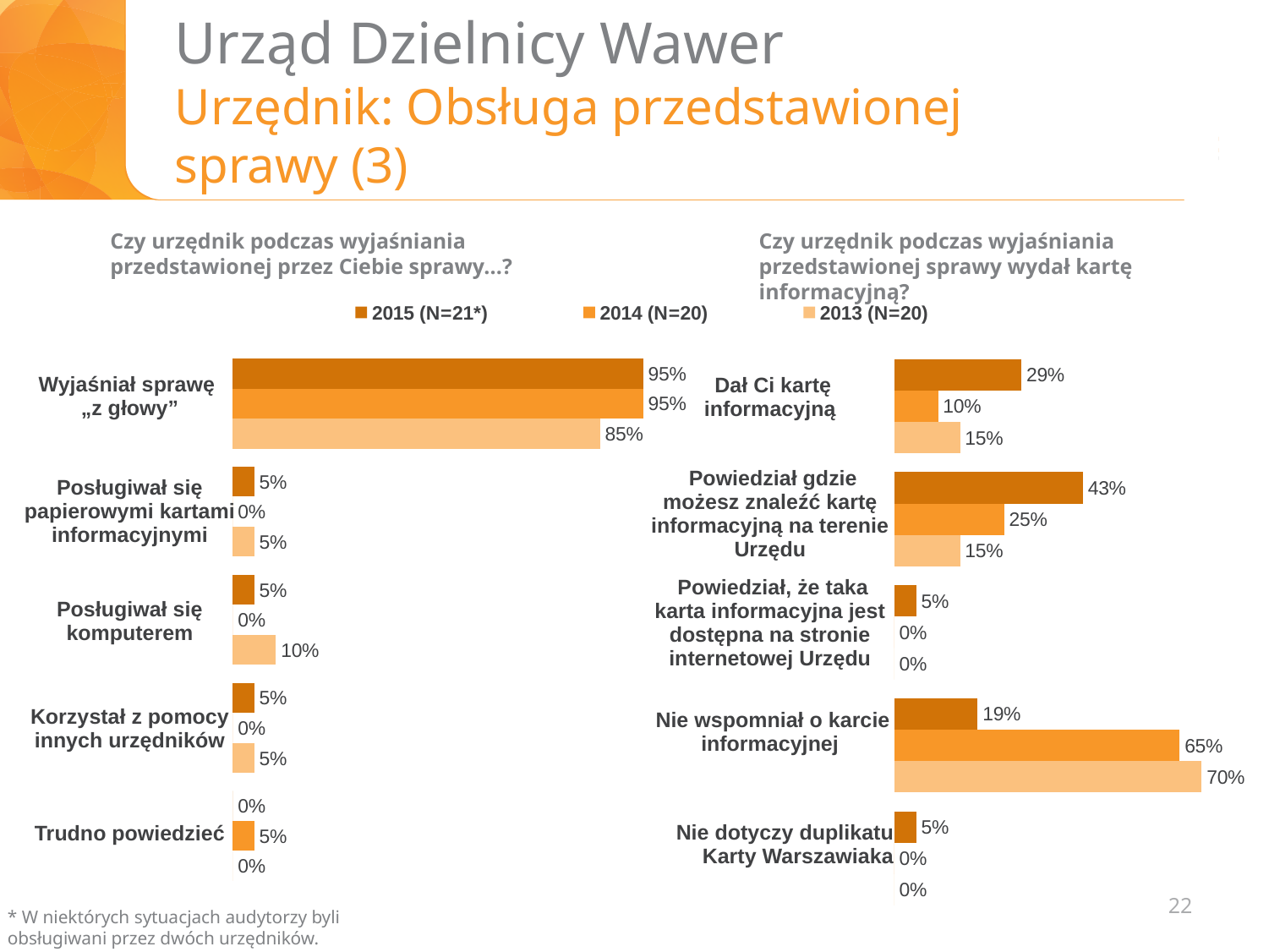
In the right chart, what is the 2014 (N=20) value for "Nie wspomniał o karcie informacyjnej"? 65% In the left chart, what is the 2013 (N=20) value for "Posługiwał się komputerem"? 10% What kind of chart is the right chart? Bar chart In the left chart, what is the 2014 (N=20) value for "Trudno powiedzieć"? 5% In the right chart, which category has the highest 2013 (N=20) value? Nie wspomniał o karcie informacyjnej How many categories does the left chart show? 5 In the left chart ("Czy urzędnik podczas wyjaśniania przedstawionej przez Ciebie sprawy...?"), what is the 2013 (N=20) value for "Wyjaśniał sprawę „z głowy”"? 85% How many series does the legend list? 3 In the right chart, what is the difference between the 2015 (N=21*) and 2014 (N=20) values for "Dał Ci kartę informacyjną"? 19 percentage points In the left chart, which category has the highest 2015 (N=21*) value? Wyjaśniał sprawę „z głowy” In the right chart, for "Nie wspomniał o karcie informacyjnej", which is larger: the 2015 (N=21*) value or the 2013 (N=20) value? 2013 (N=20) In the right chart ("Czy urzędnik podczas wyjaśniania przedstawionej sprawy wydał kartę informacyjną?"), what is the 2015 (N=21*) value for "Powiedział gdzie możesz znaleźć kartę informacyjną na terenie Urzędu"? 43%